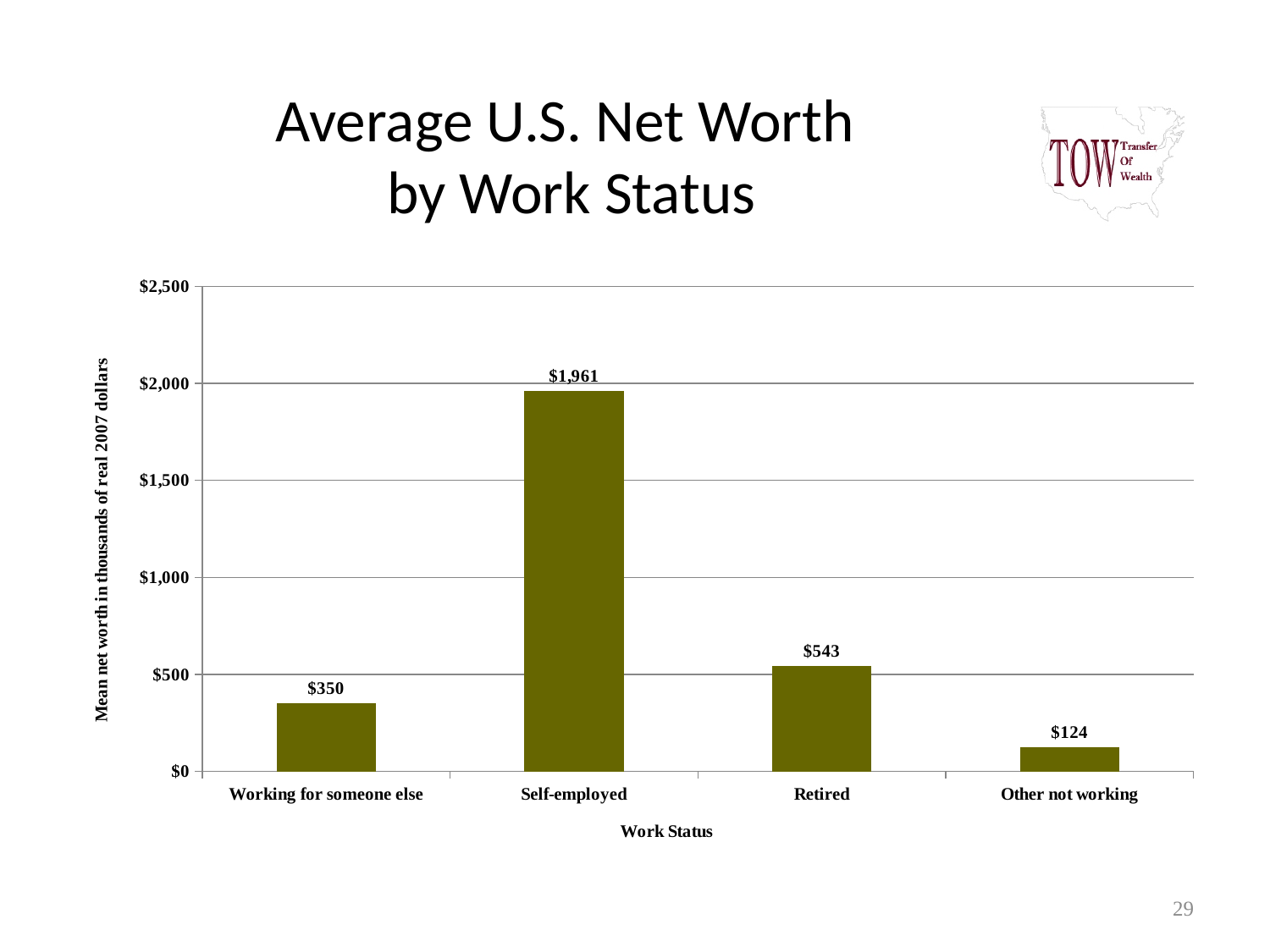
What is the mean net worth for Working for someone else? $350 How many work status categories are shown in the chart? 4 Which work status has the lowest mean net worth? Other not working What kind of chart is shown on the slide? Bar chart What is the mean net worth for Self-employed? $1,961 What is the mean net worth for Retired? $543 What is the difference between the mean net worth for Self-employed and Retired? $1,418 Is the value for Self-employed greater or less than $1,500? greater What is the difference between the mean net worth for Retired and Working for someone else? $193 Which work status has the highest mean net worth? Self-employed What is the mean net worth for Other not working? $124 Which has a larger mean net worth, Retired or Working for someone else? Retired